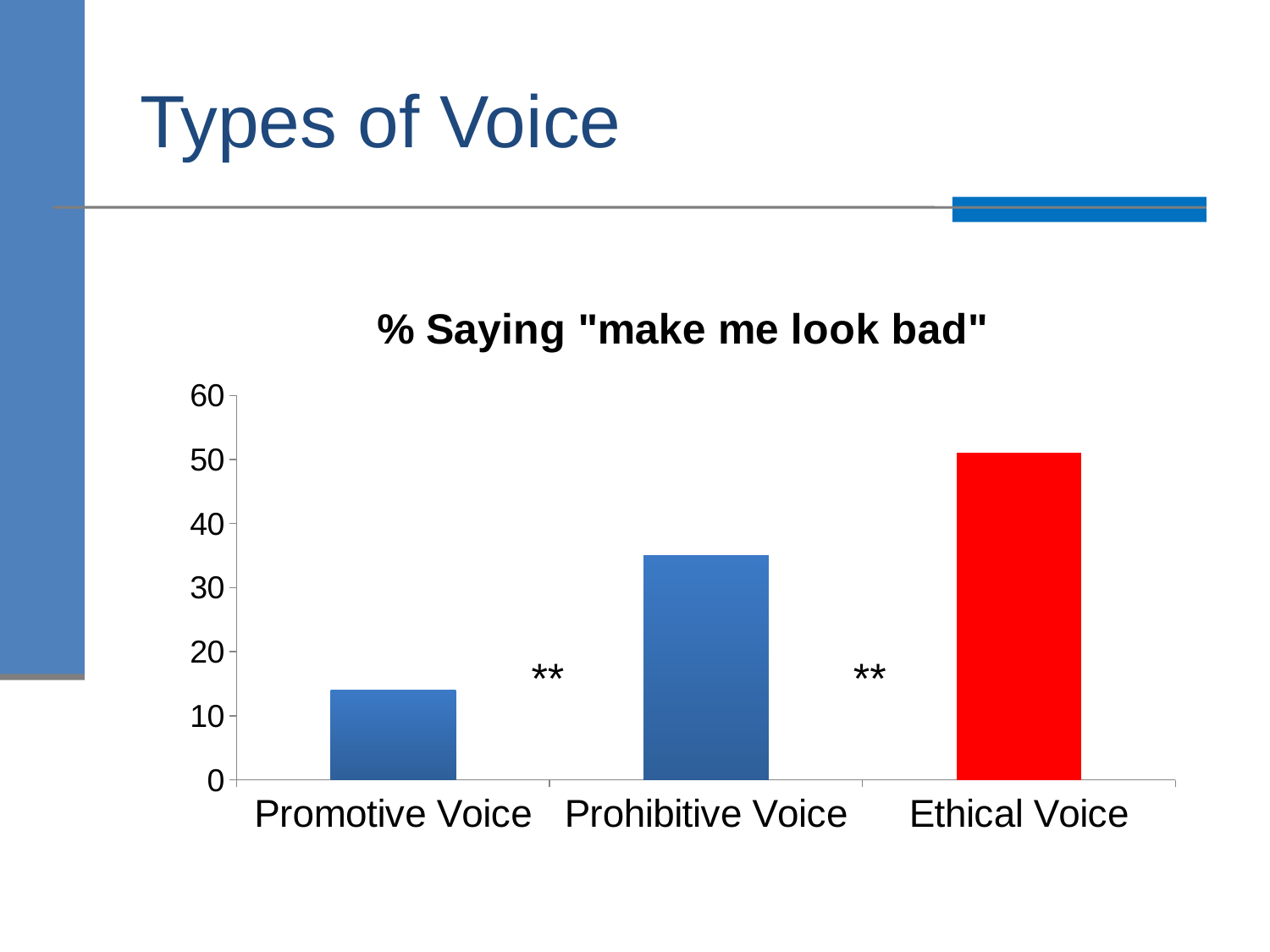
Which bar in the chart is coloured red? Ethical Voice Is the value for Promotive Voice greater or less than 20? less Is the value for Prohibitive Voice greater or less than 30? greater Which type of voice has the highest percentage saying "make me look bad"? Ethical Voice Which has a higher value, Promotive Voice or Prohibitive Voice? Prohibitive Voice Which type of voice has the lowest percentage saying "make me look bad"? Promotive Voice What is the title of the chart? % Saying "make me look bad" Do the values rise or fall moving from Promotive Voice to Ethical Voice along the x axis? rise What kind of chart is shown on the slide? bar chart How many categories are shown on the x axis of the chart? 3 Which has a higher value, Prohibitive Voice or Ethical Voice? Ethical Voice